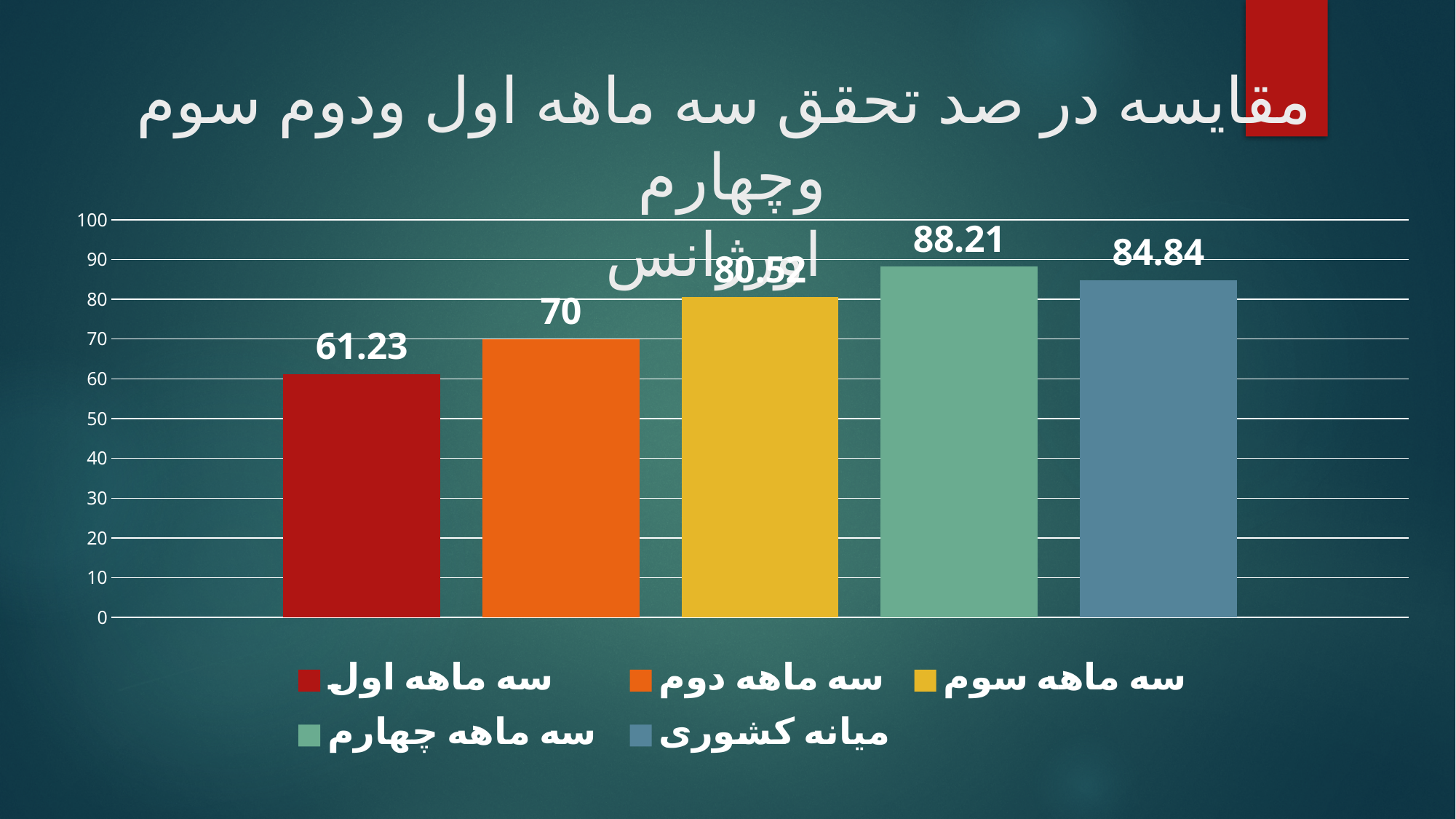
Is the value for سه ماهه اول greater or less than 70? less What is the difference between the values for سه ماهه چهارم and سه ماهه اول? 26.98 What is the value shown for سه ماهه دوم? 70 Which is larger, the value for سه ماهه چهارم or the value for میانه کشوری? سه ماهه چهارم What is the difference between the values for میانه کشوری and سه ماهه دوم? 14.84 What is the value shown for سه ماهه چهارم? 88.21 Which category has the lowest value in the chart? سه ماهه اول Which category has the highest value in the chart? سه ماهه چهارم How many bars are plotted in the chart? 5 What kind of chart is shown on the slide? bar chart What is the value shown for سه ماهه اول? 61.23 What is the value shown for میانه کشوری? 84.84